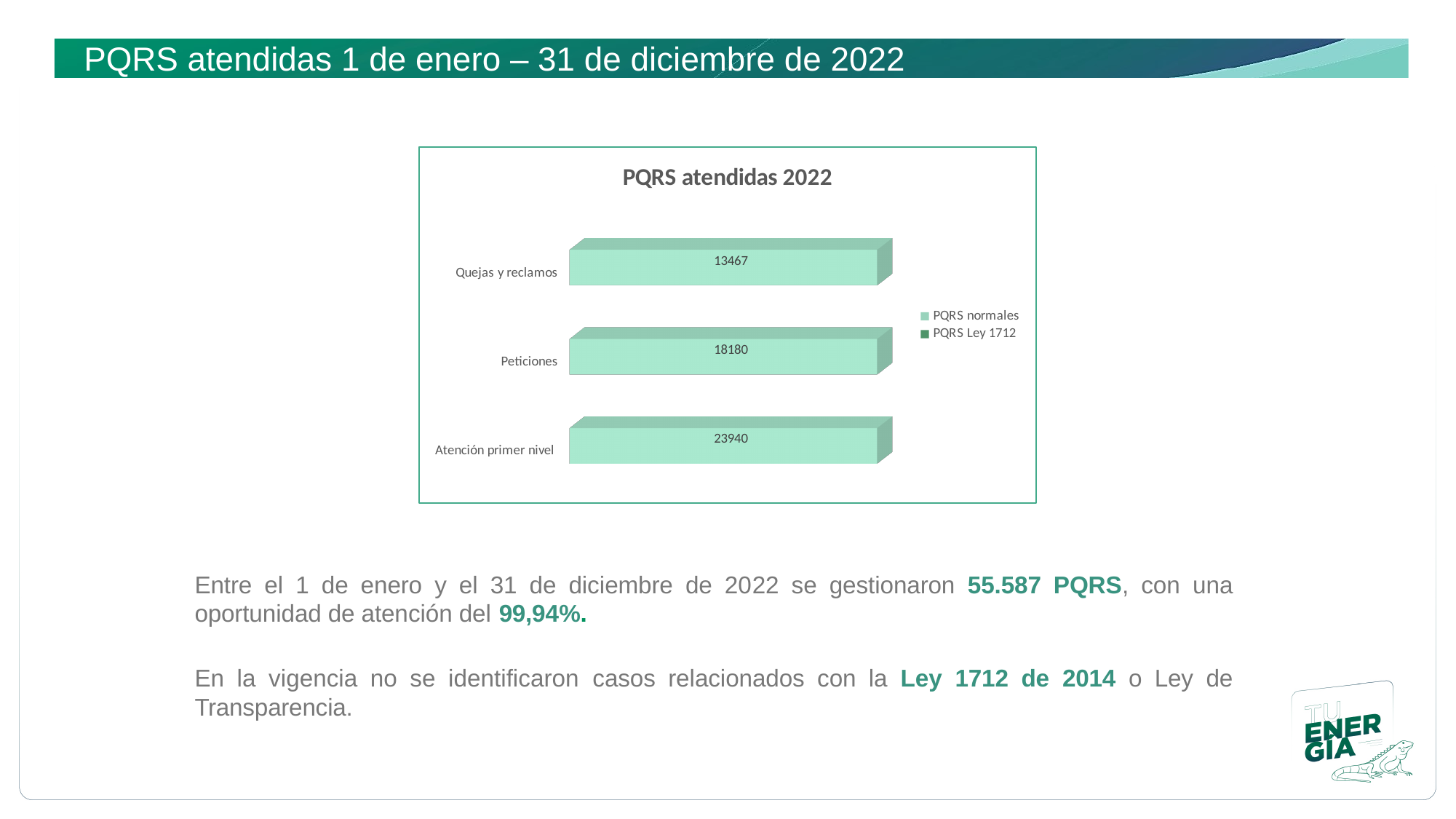
What is the value for Atención primer nivel in the PQRS atendidas 2022 chart? 23940 Which category has the highest value in the PQRS atendidas 2022 chart? Atención primer nivel What is the difference between the values for Peticiones and Quejas y reclamos in the PQRS atendidas 2022 chart? 4713 What are the two series named in the legend of the PQRS atendidas 2022 chart? PQRS normales and PQRS Ley 1712 How many series does the legend of the PQRS atendidas 2022 chart list? 2 What is the difference between the values for Atención primer nivel and Peticiones in the PQRS atendidas 2022 chart? 5760 What kind of chart is the PQRS atendidas 2022 chart? Bar chart What is the value for Peticiones in the PQRS atendidas 2022 chart? 18180 Which category has the lowest value in the PQRS atendidas 2022 chart? Quejas y reclamos How many categories are shown in the PQRS atendidas 2022 chart? 3 Which is larger in the PQRS atendidas 2022 chart, the value for Peticiones or the value for Quejas y reclamos? Peticiones What is the value for Quejas y reclamos in the PQRS atendidas 2022 chart? 13467